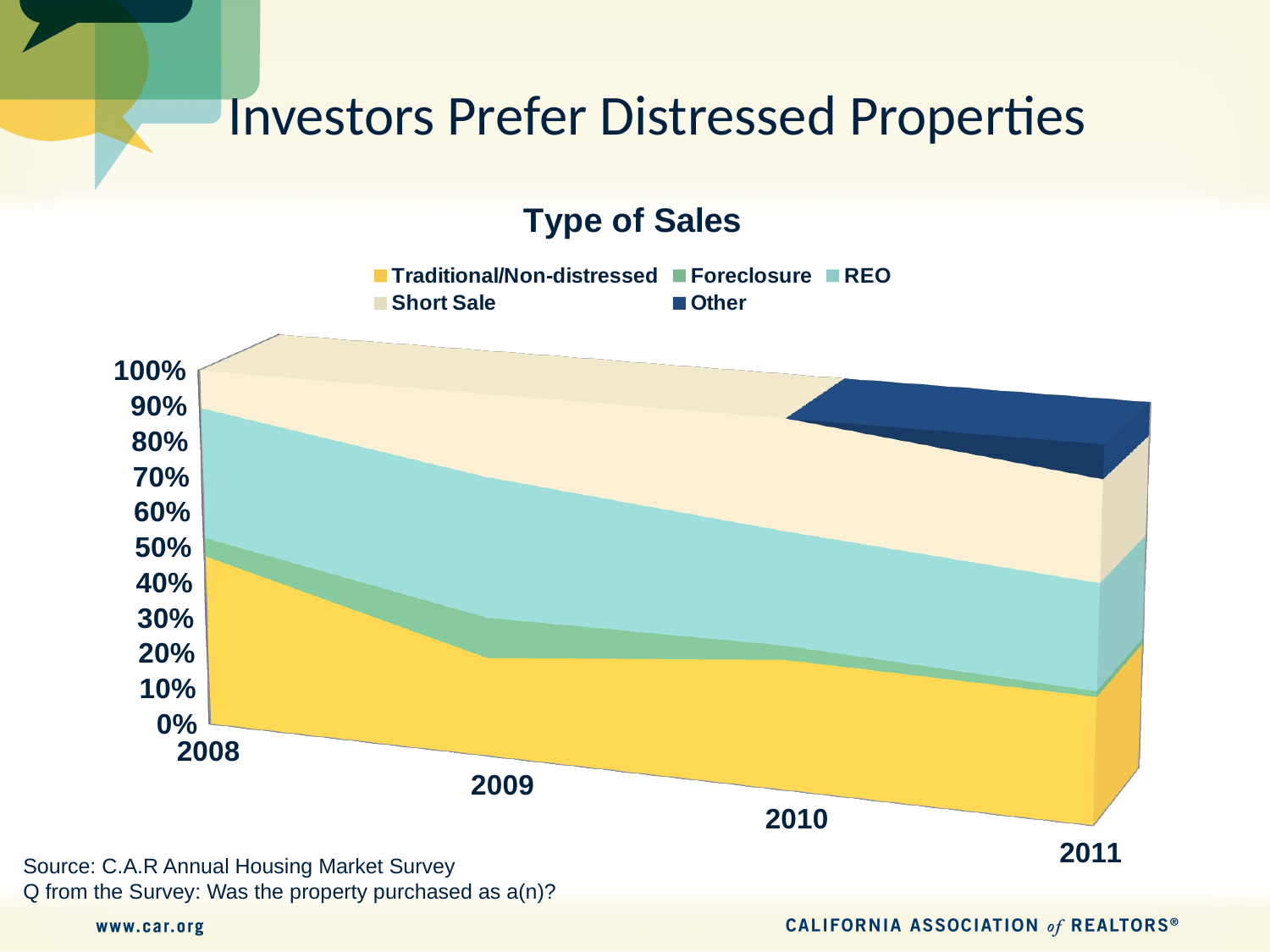
Does the Traditional/Non-distressed share rise or fall from 2008 to 2011? Fall Does the Short Sale share rise or fall from 2008 to 2011? Rise What kind of chart is shown on the slide? Area chart Which series is plotted at the bottom of the stacked area chart? Traditional/Non-distressed In which year is the Traditional/Non-distressed share highest? 2008 In which year does the Other category first appear with a visible share? 2011 Is the Traditional/Non-distressed share in 2008 greater or less than 40%? greater Which year has the larger Traditional/Non-distressed share, 2008 or 2011? 2008 What is the title of the chart? Type of Sales How many series does the legend list? 5 How many years are shown along the x axis? 4 Is the Traditional/Non-distressed share in 2009 greater or less than 30%? less